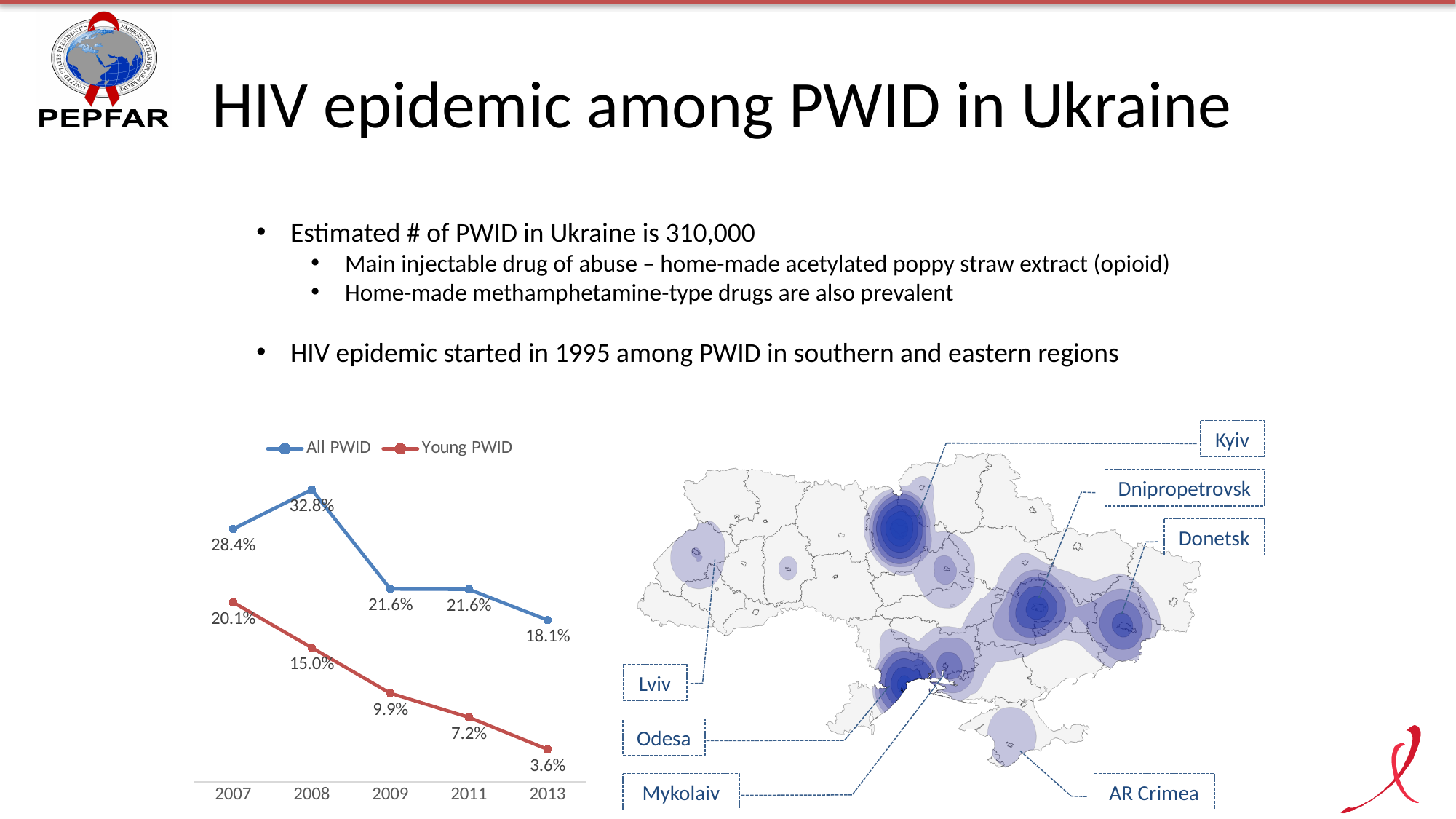
What is the difference between the All PWID and Young PWID values in 2007? 8.3% What kind of chart is shown on the left of the slide? Line chart In which year is the All PWID value highest? 2008 How many years are shown on the x axis of the line chart? 5 In which year is the Young PWID value lowest? 2013 What is the value for All PWID in 2013? 18.1% What is the value for Young PWID in 2009? 9.9% What is the value for All PWID in 2008? 32.8% What is the value for Young PWID in 2013? 3.6% How many series does the legend of the line chart list? 2 Does the Young PWID series rise or fall from 2007 to 2013? Fall Which is larger in 2011: the All PWID value or the Young PWID value? All PWID